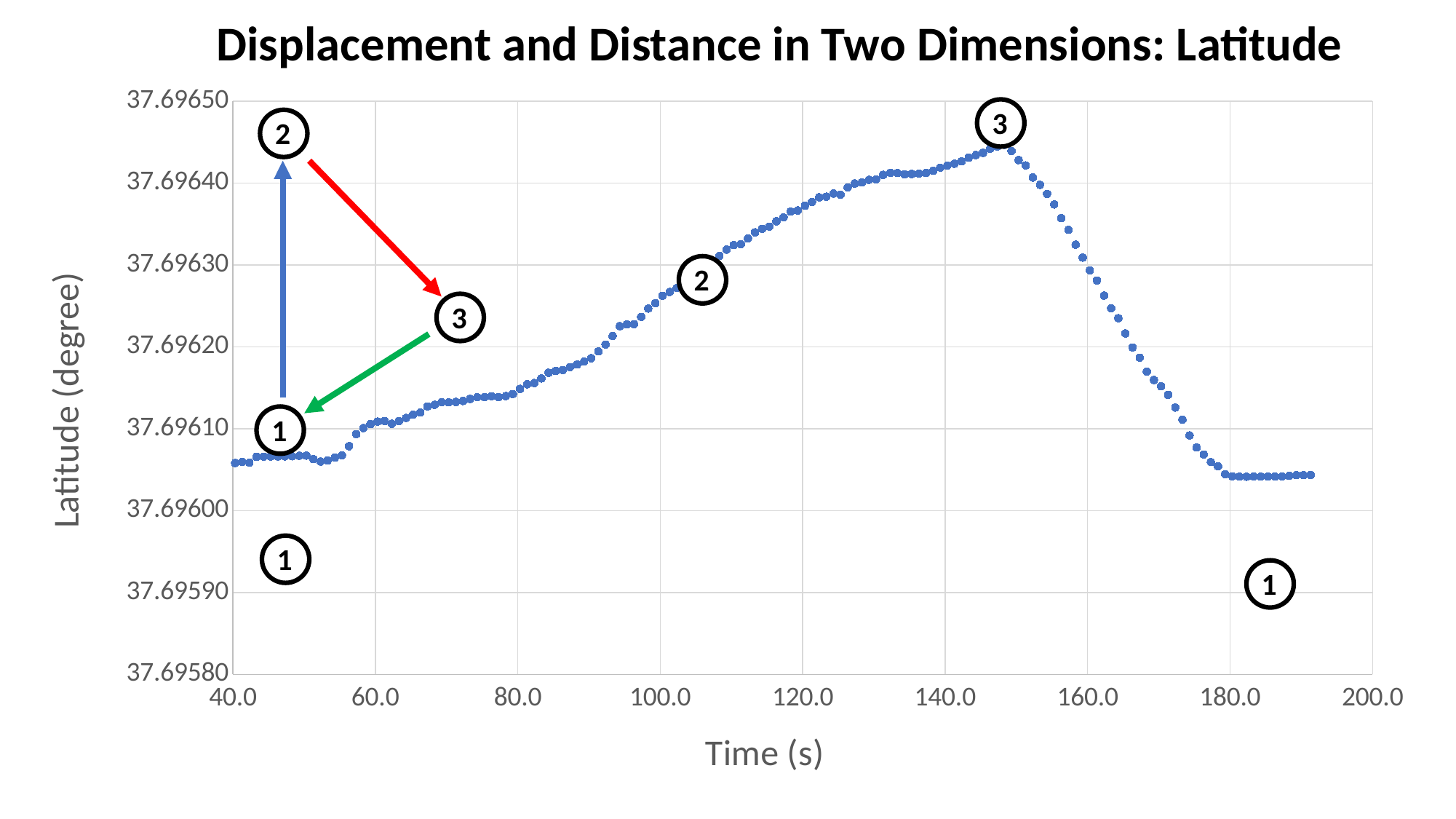
Which has the larger latitude value: time 100.0 s or time 180.0 s? 100.0 s Is the highest latitude value plotted greater or less than 37.69640? greater Does the latitude rise or fall between time 150.0 s and time 180.0 s? fall What kind of chart is shown on the slide? Scatter chart Is the latitude value at time 100.0 s greater or less than 37.69620? greater What is the label of the vertical axis? Latitude (degree) What is the title of the chart? Displacement and Distance in Two Dimensions: Latitude Is the lowest latitude value plotted greater or less than 37.69610? less Does the latitude rise or fall between time 40.0 s and time 140.0 s? rise